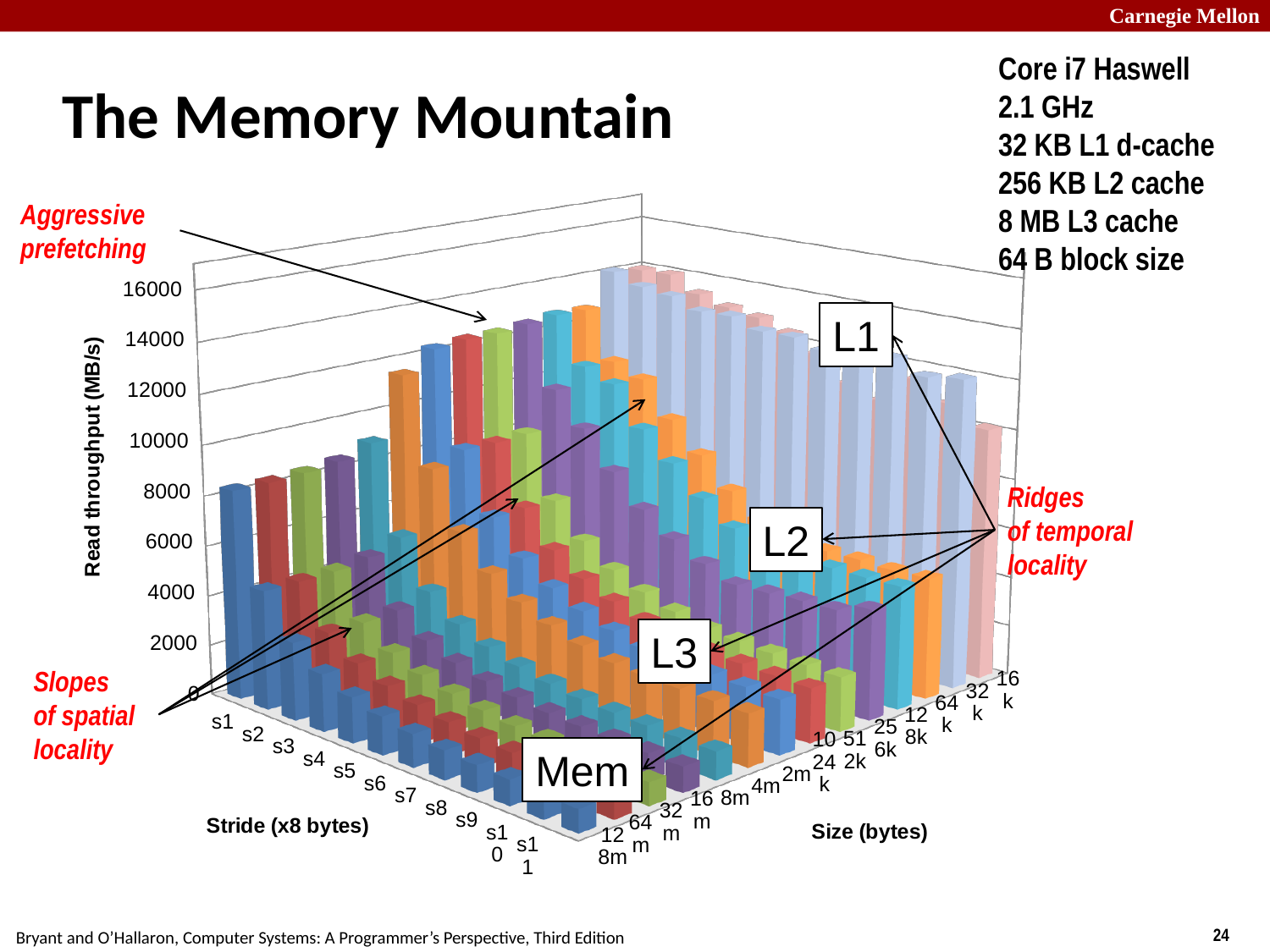
What kind of chart is shown on the slide? bar chart At stride s1, does read throughput rise or fall as the size decreases from 128m toward 16k? rise What is the highest tick value shown on the Read throughput axis? 16000 What is the title of the chart on the slide? The Memory Mountain Is the read throughput for stride s11 at size 128m greater or less than 4000? less For a given size, does read throughput rise or fall as the stride increases from s1 to s11? fall Which stride gives the highest read throughput across the chart? s1 Is the read throughput for stride s1 at size 128m greater or less than 12000? less How many stride categories (s1, s2, ...) are shown along the stride axis? 11 What is the label of the vertical axis of the chart? Read throughput (MB/s) How many size categories are shown along the Size (bytes) axis? 14